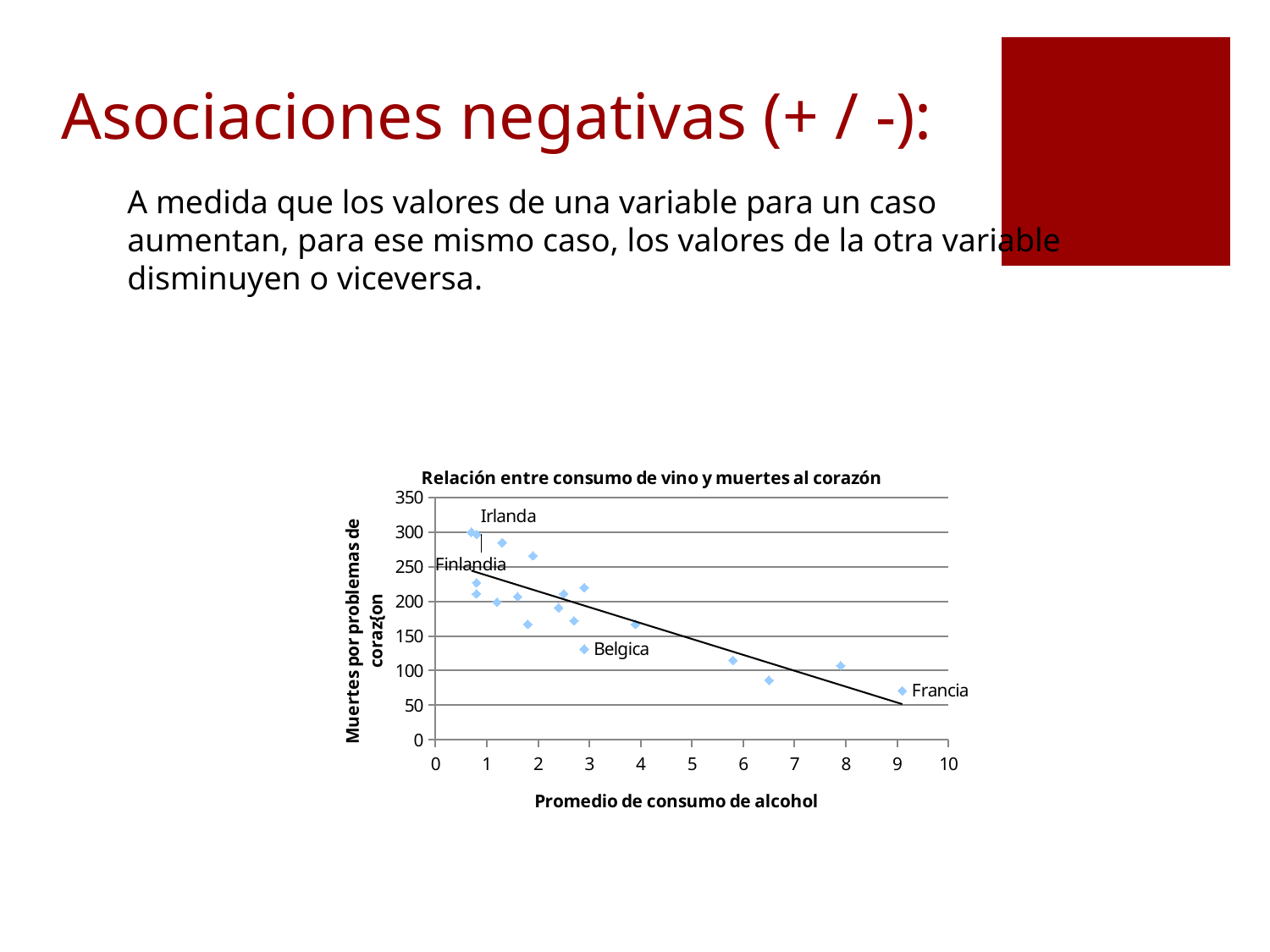
As the average alcohol consumption increases along the x axis, do the heart-death values generally rise or fall? fall Is the value for Irlanda on the y axis greater or less than 250? greater Which has more heart deaths, Belgica or Francia? Belgica Is the x-axis value for Belgica greater or less than 2? greater What kind of chart is shown on the slide? scatter chart Is the value for Belgica on the y axis greater or less than 150? less What is the label of the x axis? Promedio de consumo de alcohol What is the title of the chart? Relación entre consumo de vino y muertes al corazón Which has more heart deaths, Irlanda or Francia? Irlanda